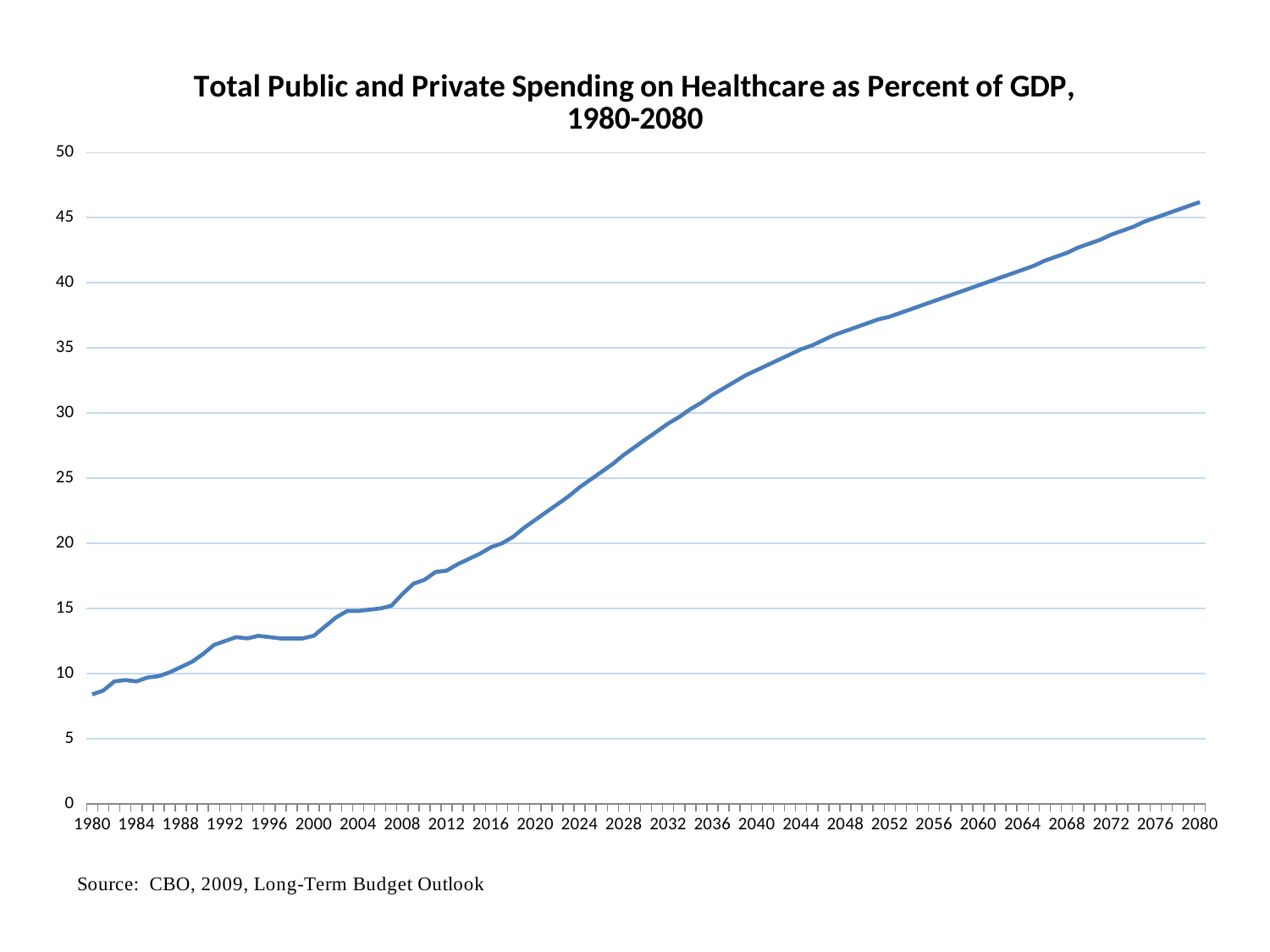
Is the value for 2080 greater or less than 45? greater Is the value for 2000 greater or less than 15? less Is the value for 2048 greater or less than 35? greater In which year is healthcare spending as a percent of GDP highest? 2080 What kind of chart is shown on the slide? line chart Which year has the larger value, 2000 or 2040? 2040 What source is cited below the chart? CBO, 2009, Long-Term Budget Outlook In which year is healthcare spending as a percent of GDP lowest? 1980 Do the values generally rise or fall from 1980 to 2080? rise What is the title of the chart? Total Public and Private Spending on Healthcare as Percent of GDP, 1980-2080